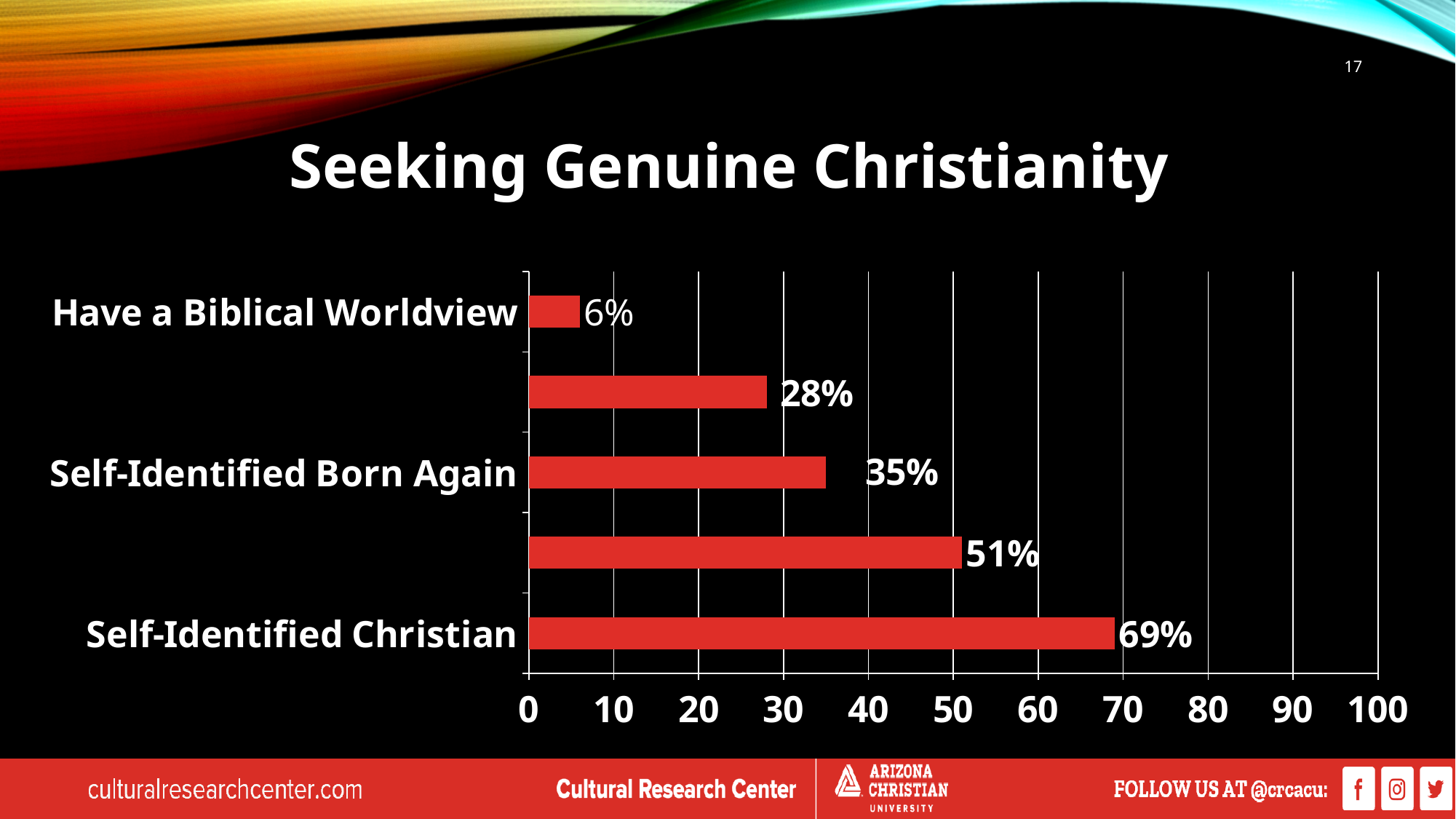
What kind of chart is shown on the slide? bar chart Which is larger, the value for Self-Identified Born Again or the value for Have a Biblical Worldview? Self-Identified Born Again What is the difference between the values for Self-Identified Christian and Self-Identified Born Again? 34% Is the value for Self-Identified Christian greater or less than 60? greater How many bars are plotted in the chart? 5 Which category has the lowest value? Have a Biblical Worldview What is the value for Have a Biblical Worldview? 6% Which category has the highest value? Self-Identified Christian What is the difference between the values for Self-Identified Born Again and Have a Biblical Worldview? 29% What is the value for Self-Identified Christian? 69% What is the title of the slide? Seeking Genuine Christianity What is the value for Self-Identified Born Again? 35%